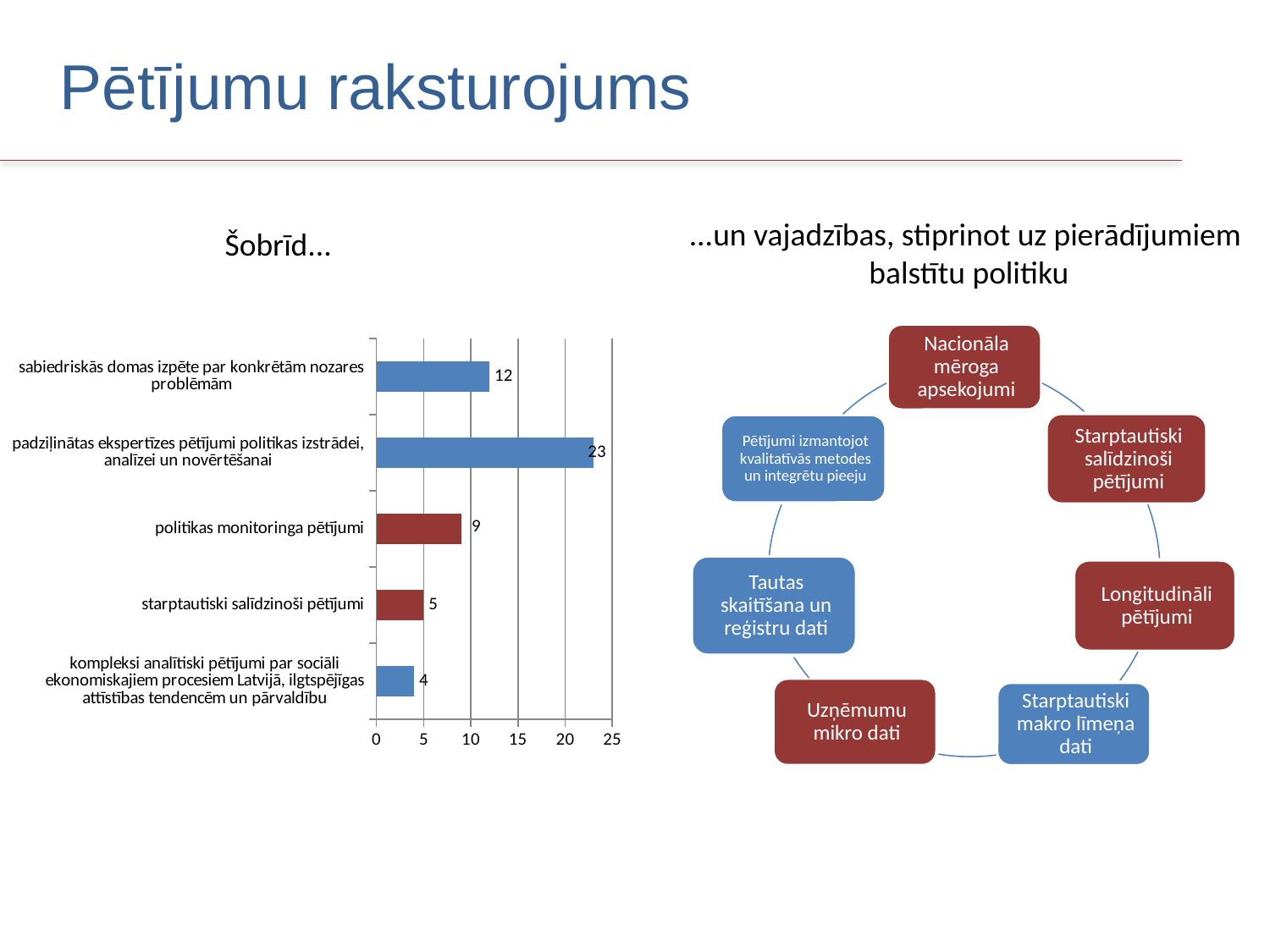
What is the difference between the values for "padziļinātas ekspertīzes pētījumi politikas izstrādei, analīzei un novērtēšanai" and "sabiedriskās domas izpēte par konkrētām nozares problēmām"? 11 What is the title shown above the bar chart? Šobrīd... Which category has the lowest value in the chart? kompleksi analītiski pētījumi par sociāli ekonomiskajiem procesiem Latvijā, ilgtspējīgas attīstības tendencēm un pārvaldību What type of chart is shown on the slide? bar chart Which is larger: the value for "politikas monitoringa pētījumi" or the value for "starptautiski salīdzinoši pētījumi"? politikas monitoringa pētījumi What is the value for "politikas monitoringa pētījumi"? 9 Which category has the highest value in the chart? padziļinātas ekspertīzes pētījumi politikas izstrādei, analīzei un novērtēšanai How many categories are shown in the bar chart? 5 Is the value for "sabiedriskās domas izpēte par konkrētām nozares problēmām" greater or less than 10? greater What is the value for "starptautiski salīdzinoši pētījumi"? 5 What is the value for "padziļinātas ekspertīzes pētījumi politikas izstrādei, analīzei un novērtēšanai"? 23 What is the value for "sabiedriskās domas izpēte par konkrētām nozares problēmām"? 12